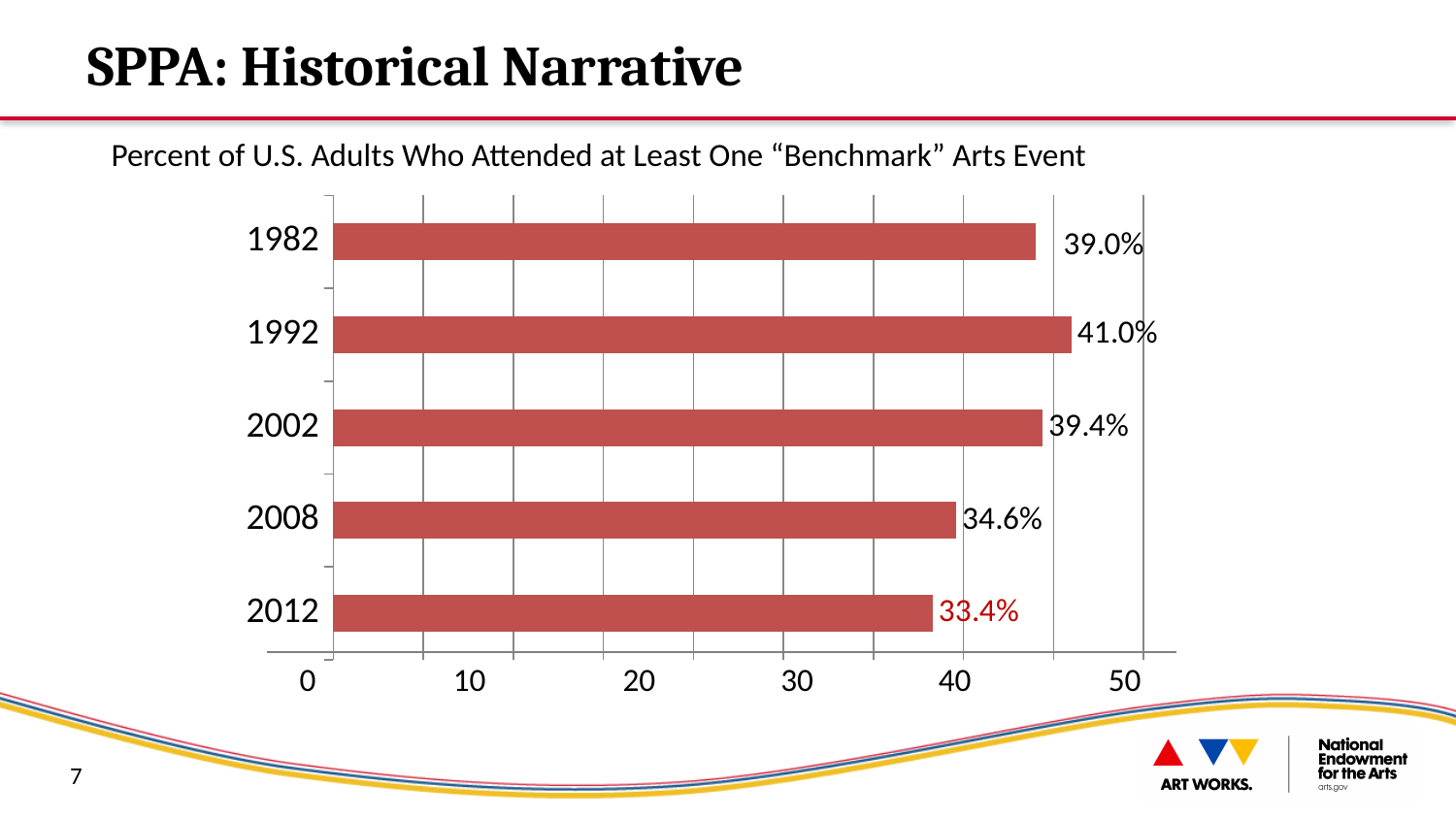
Which is larger, the value for 1982 or the value for 2002? 2002 What is the difference between the 2002 value and the 2008 value? 4.8 percentage points What kind of chart is shown on the slide? Bar chart Which year has the lowest percentage of adults attending a benchmark arts event? 2012 What is the value shown for 2008? 34.6% What percent of U.S. adults attended at least one benchmark arts event in 1982? 39.0% How many years are shown on the chart? 5 What is the difference between the 1992 value and the 2012 value? 7.6 percentage points Is the value for 2008 greater or less than 40? less What is the value shown for 2012? 33.4% What is the title of the chart? Percent of U.S. Adults Who Attended at Least One "Benchmark" Arts Event Which year has the highest percentage of adults attending a benchmark arts event? 1992